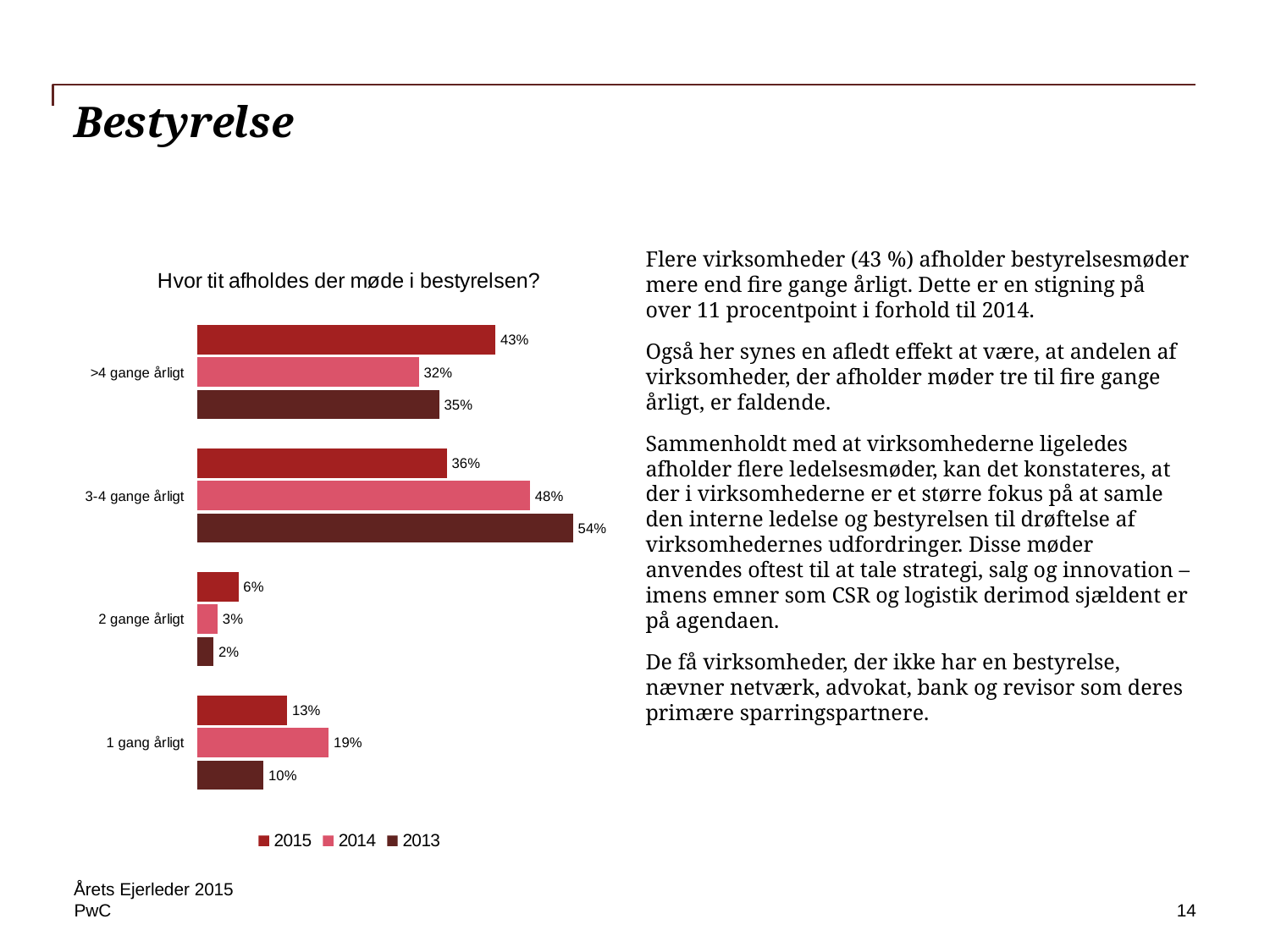
What is the difference between the 2013 and 2015 values for '1 gang årligt'? 3 percentage points How many series does the legend list? 3 What is the value for '>4 gange årligt' in the 2015 series? 43% What is the title of the chart? Hvor tit afholdes der møde i bestyrelsen? What is the value for '3-4 gange årligt' in the 2013 series? 54% How many categories are shown on the chart? 4 What kind of chart is shown on the slide? Bar chart Which is larger for '3-4 gange årligt': the 2015 value or the 2013 value? 2013 What is the value for '1 gang årligt' in the 2014 series? 19% What is the difference between the 2015 and 2014 values for '>4 gange årligt'? 11 percentage points Which category has the lowest value in the 2013 series? 2 gange årligt Which category has the highest value in the 2014 series? 3-4 gange årligt